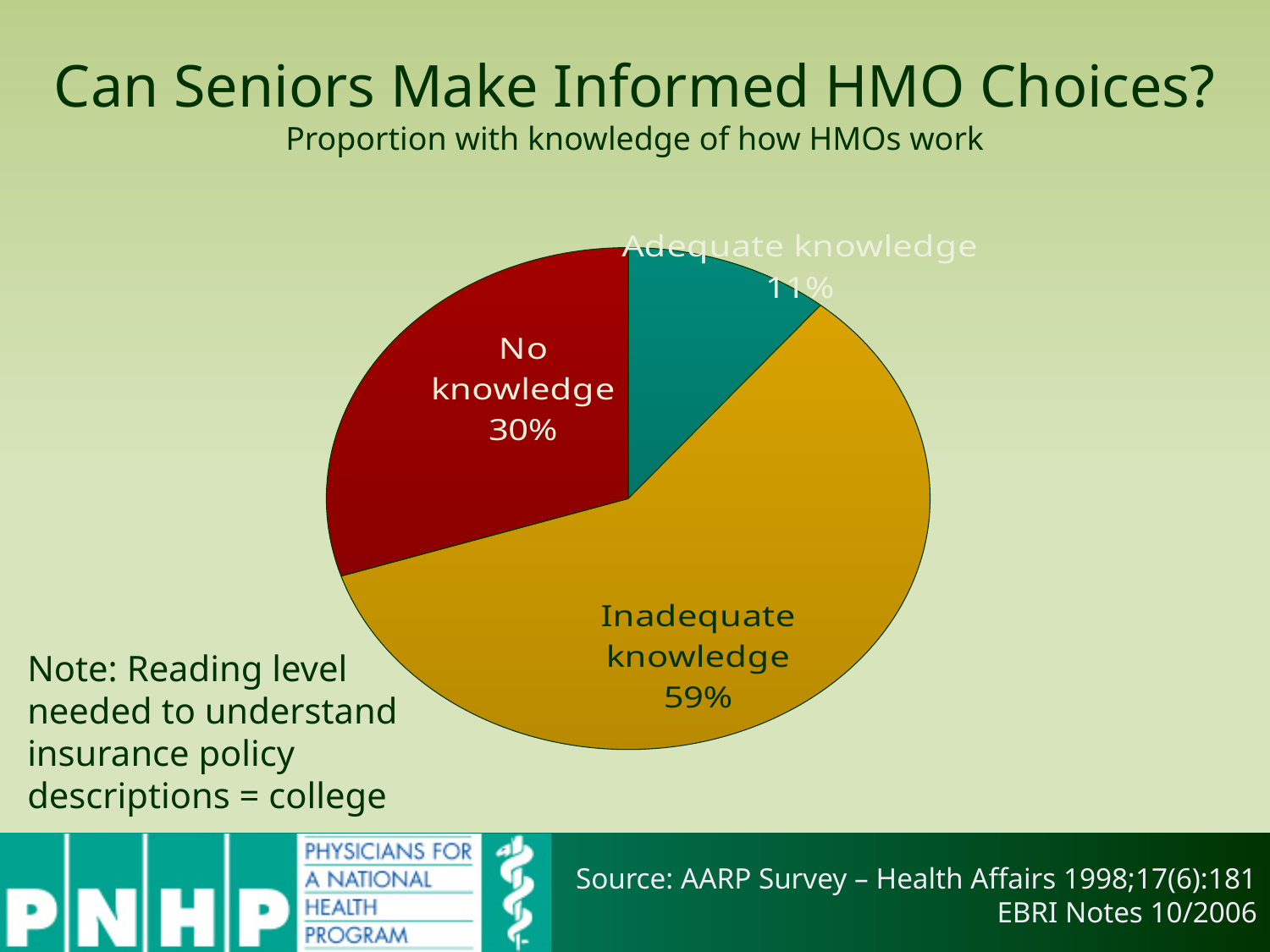
Which category has the smallest share of the pie? Adequate knowledge Which category has the largest share of the pie? Inadequate knowledge What is the difference in percentage points between the No knowledge and Adequate knowledge slices? 19 What is the difference in percentage points between the Inadequate knowledge and No knowledge slices? 29 What percentage of seniors have inadequate knowledge of how HMOs work? 59% What colour is the Inadequate knowledge slice? gold/yellow What is the subtitle of the chart on the slide? Proportion with knowledge of how HMOs work What percentage of seniors have adequate knowledge of how HMOs work? 11% Which is larger, the No knowledge slice or the Adequate knowledge slice? No knowledge What kind of chart is shown on the slide? pie chart What percentage of seniors have no knowledge of how HMOs work? 30% How many slices does the pie chart have? 3